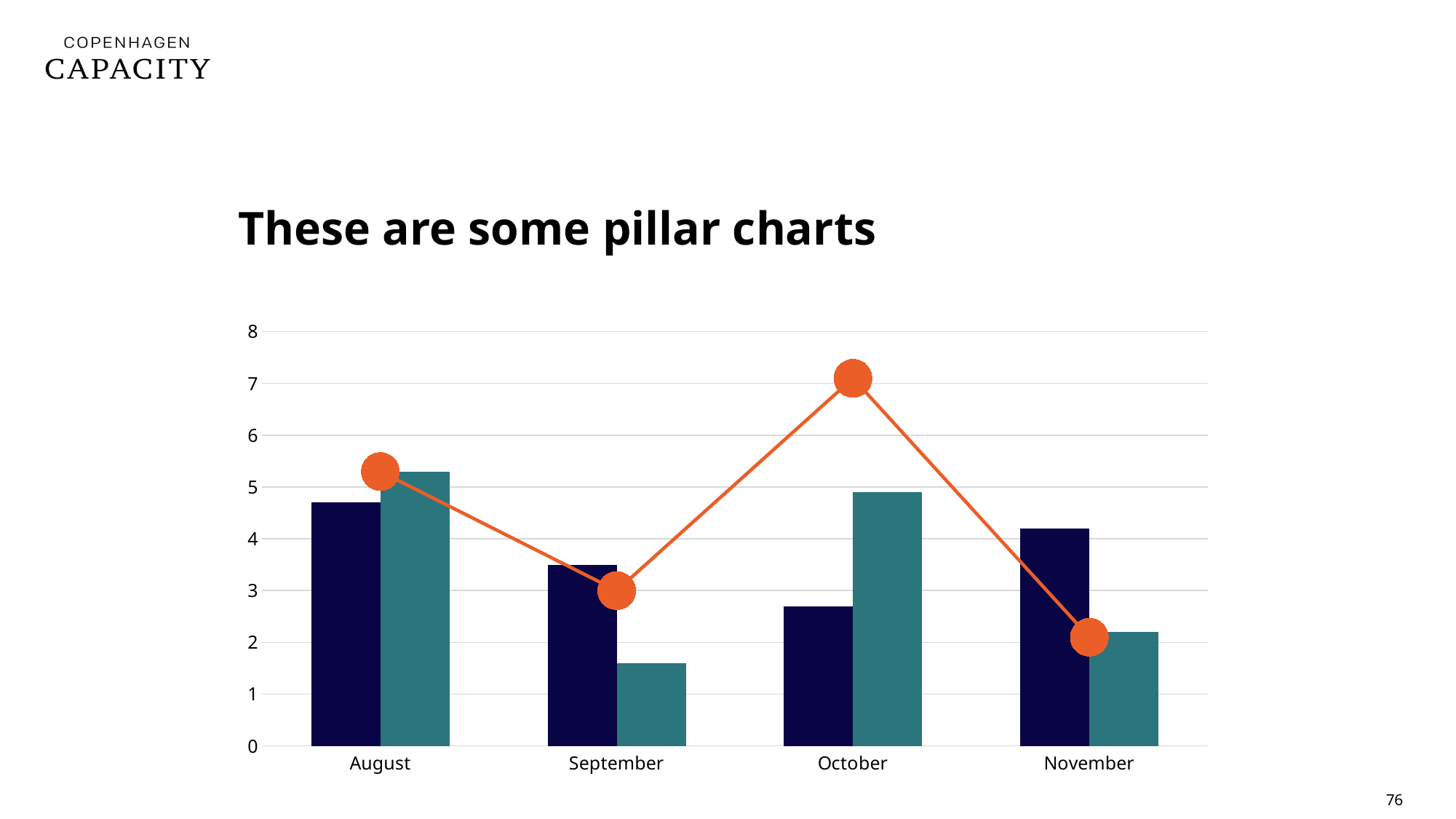
In which month is the dark navy bar the shortest? October How many categories are shown on the x axis? 4 In which month does the orange line reach its highest point? October In October, which bar is taller, the dark navy bar or the teal bar? The teal bar Does the orange line rise or fall from September to October? It rises Is the value of the teal bar in September greater or less than 2? less In which month is the teal bar the tallest? August In which month is the teal bar the shortest? September What is the title of the slide above the chart? These are some pillar charts In which month does the orange line reach its lowest point? November What kind of chart is shown on the slide? A bar chart combined with a line Is the value of the orange line in October greater or less than 6? greater